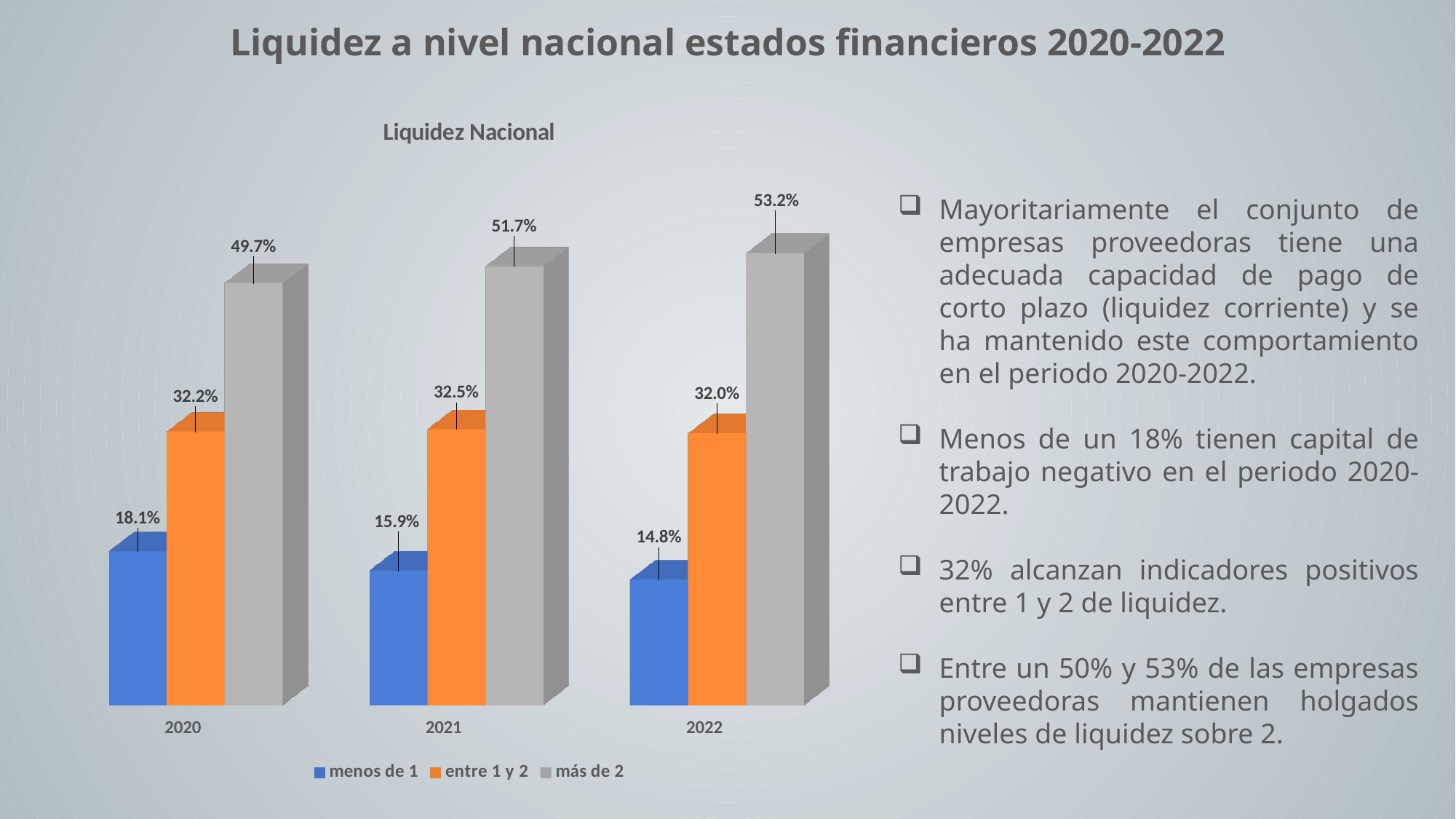
What is the difference between the "más de 2" values for 2022 and 2020? 3.5% In which year is the "menos de 1" series lowest? 2022 What is the title of the chart? Liquidez Nacional Which is larger in 2021: "entre 1 y 2" or "menos de 1"? entre 1 y 2 What kind of chart is shown? bar chart What is the value for "menos de 1" in 2020? 18.1% How many years are shown on the x axis? 3 In which year is the "más de 2" series highest? 2022 Does the "menos de 1" series rise or fall from 2020 to 2022? fall What is the value for "entre 1 y 2" in 2021? 32.5% How many series does the legend list? 3 What is the value for "más de 2" in 2022? 53.2%